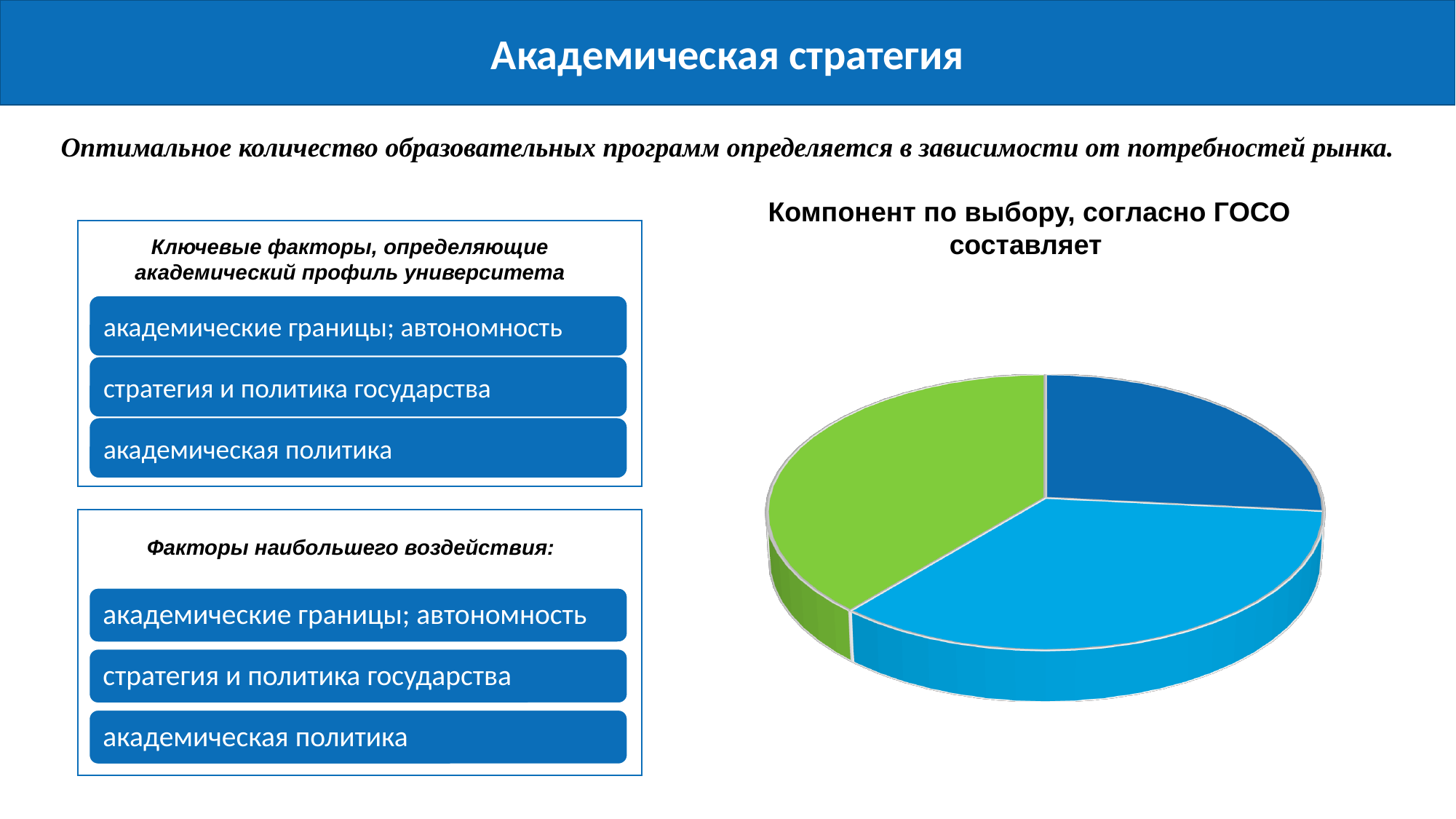
What colours are the slices of the pie chart? dark blue, light blue and green Does the pie chart display a legend? No What kind of chart is shown on the right side of the slide? pie chart What is the title of the pie chart? Компонент по выбору, согласно ГОСО составляет In the pie chart, which is larger: the light blue slice or the dark blue slice? light blue How many slices does the pie chart have? 3